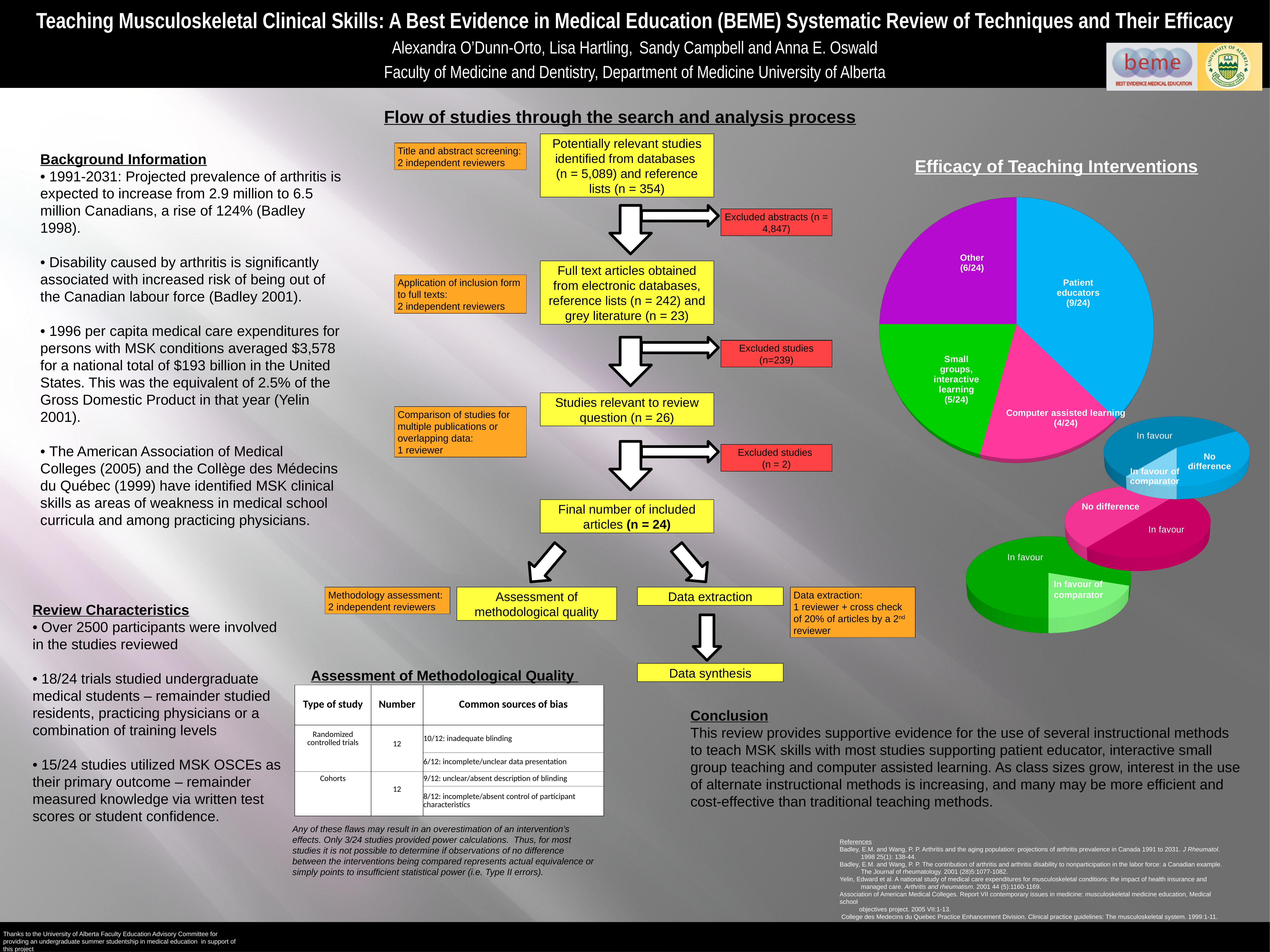
What is the title of the large pie chart on the right side of the slide? Efficacy of Teaching Interventions In the Efficacy of Teaching Interventions pie chart, which category has the smallest slice? Computer assisted learning In the Efficacy of Teaching Interventions pie chart, which is larger: Other or Small groups, interactive learning? Other In the Efficacy of Teaching Interventions pie chart, what is the difference between the Patient educators value and the Computer assisted learning value? 5/24 In the Efficacy of Teaching Interventions pie chart, what value is shown for Patient educators? 9/24 In the Efficacy of Teaching Interventions pie chart, what value is shown for the Other slice? 6/24 In the Efficacy of Teaching Interventions pie chart, which category has the largest slice? Patient educators What kind of chart is the Efficacy of Teaching Interventions chart? Pie chart How many slices does the Efficacy of Teaching Interventions pie chart have? 4 In the Efficacy of Teaching Interventions pie chart, what value is shown for Small groups, interactive learning? 5/24 How many smaller pie charts appear below and to the right of the main Efficacy of Teaching Interventions pie chart? 3 In the Efficacy of Teaching Interventions pie chart, what value is shown for Computer assisted learning? 4/24